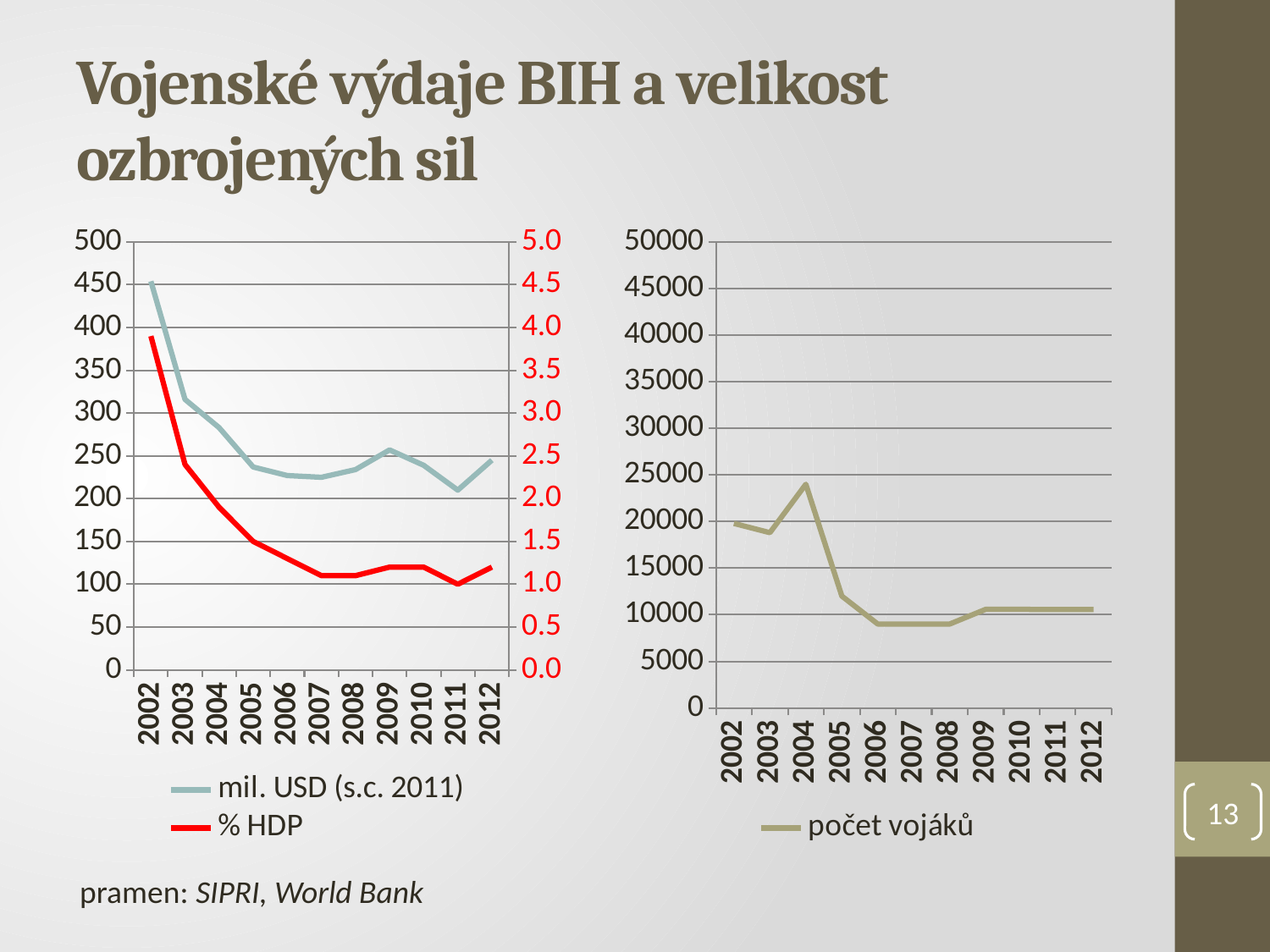
How many years are plotted on the x axis of the right chart (počet vojáků)? 11 In the left chart, does the % HDP series generally rise or fall from 2002 to 2012? fall In the left chart, is the value for mil. USD (s.c. 2011) in 2002 greater or less than 400? greater In the left chart, which year has the highest value for mil. USD (s.c. 2011)? 2002 In the right chart, which year has the highest počet vojáků? 2004 In the left chart, which year has the highest value for % HDP? 2002 In the right chart, is the počet vojáků in 2006 greater or less than 10000? less What kind of chart is the left chart on the slide? line chart In the right chart, is the počet vojáků in 2004 greater or less than 20000? greater In the right chart, which year has the larger počet vojáků, 2004 or 2005? 2004 How many series does the legend of the left chart list? 2